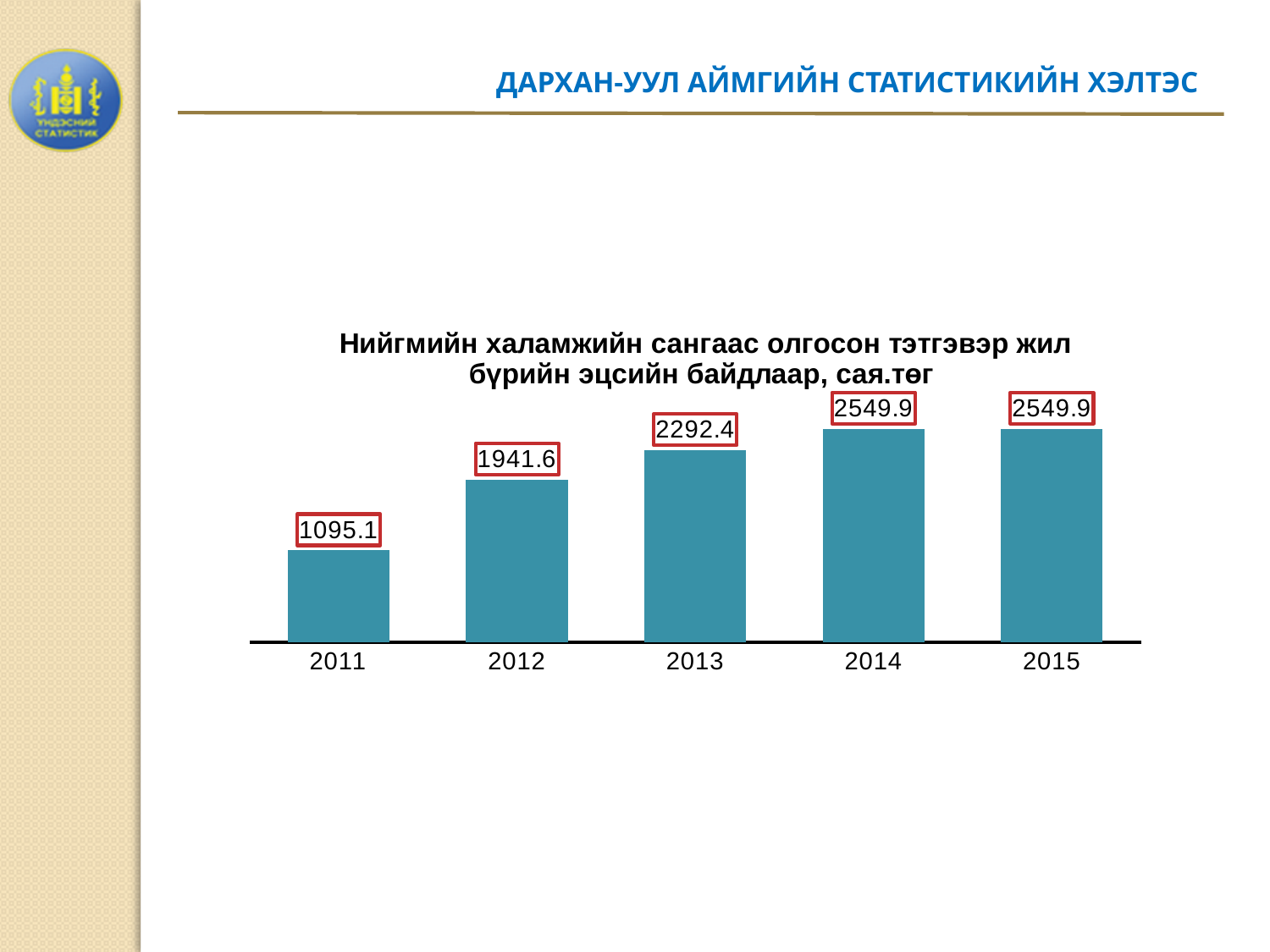
What is the difference between the values for 2013 and 2012? 350.8 Are the values for 2014 and 2015 the same or different? the same What kind of chart is this? bar chart What is the value for 2011? 1095.1 Which is larger, the value for 2012 or the value for 2013? 2013 How many years are shown on the x axis? 5 What is the value for 2013? 2292.4 What is the difference between the values for 2015 and 2011? 1454.8 What is the difference between the values for 2012 and 2011? 846.5 Do the values rise or fall from 2011 to 2014? rise What is the value for 2015? 2549.9 Which year has the lowest value? 2011